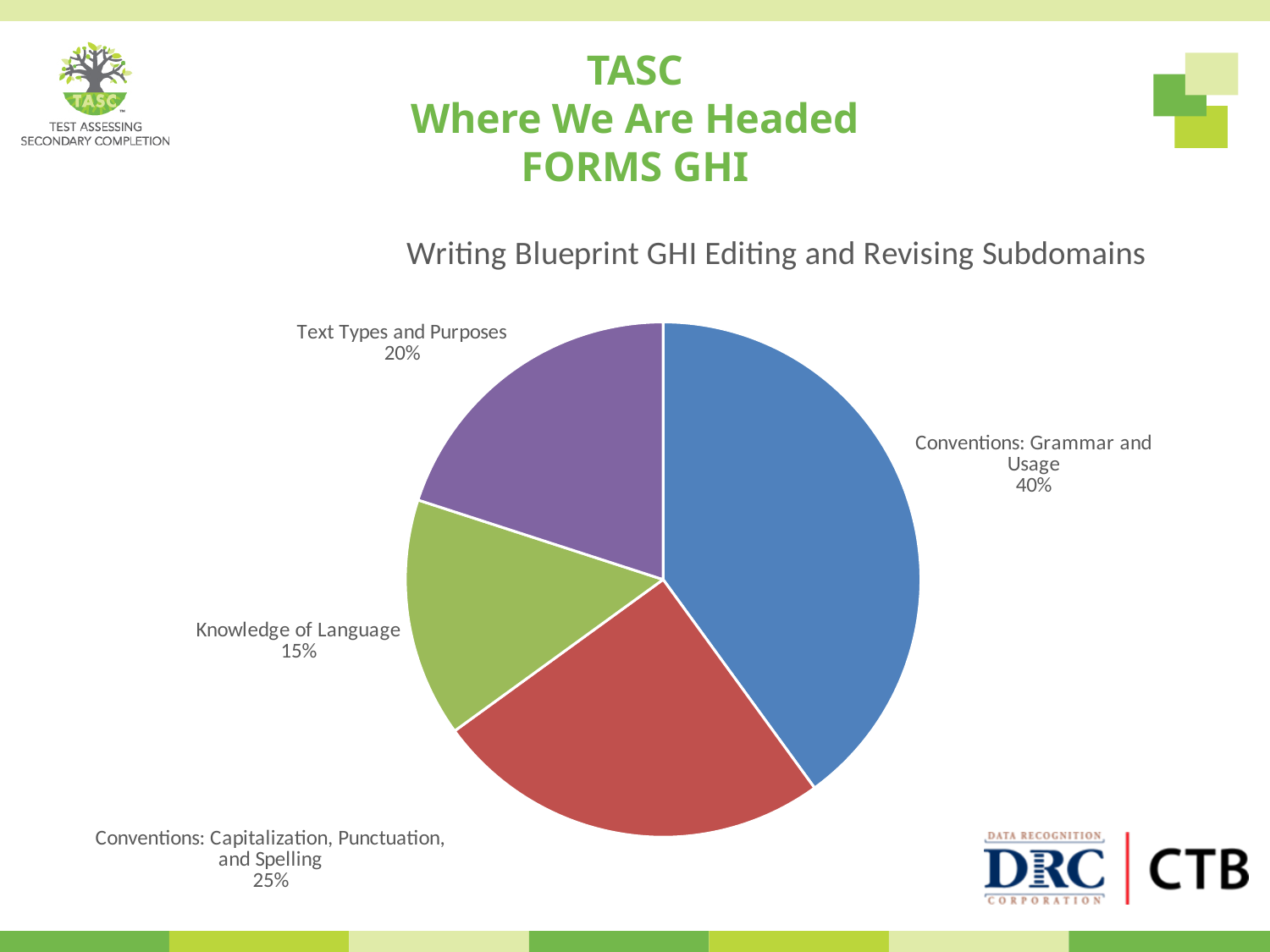
How many slices does the pie chart have? 4 What colour is the slice for Text Types and Purposes? purple What is the difference in percentage points between Conventions: Grammar and Usage and Text Types and Purposes? 20 What is the title of the chart? Writing Blueprint GHI Editing and Revising Subdomains Which subdomain has the smallest share of the pie? Knowledge of Language Which is larger, the share for Conventions: Capitalization, Punctuation, and Spelling or the share for Knowledge of Language? Conventions: Capitalization, Punctuation, and Spelling What percentage is shown for Conventions: Capitalization, Punctuation, and Spelling? 25% Which subdomain has the largest share of the pie? Conventions: Grammar and Usage What percentage is shown for Conventions: Grammar and Usage? 40% What percentage is shown for Knowledge of Language? 15% What type of chart is shown on the slide? pie chart What percentage is shown for Text Types and Purposes? 20%